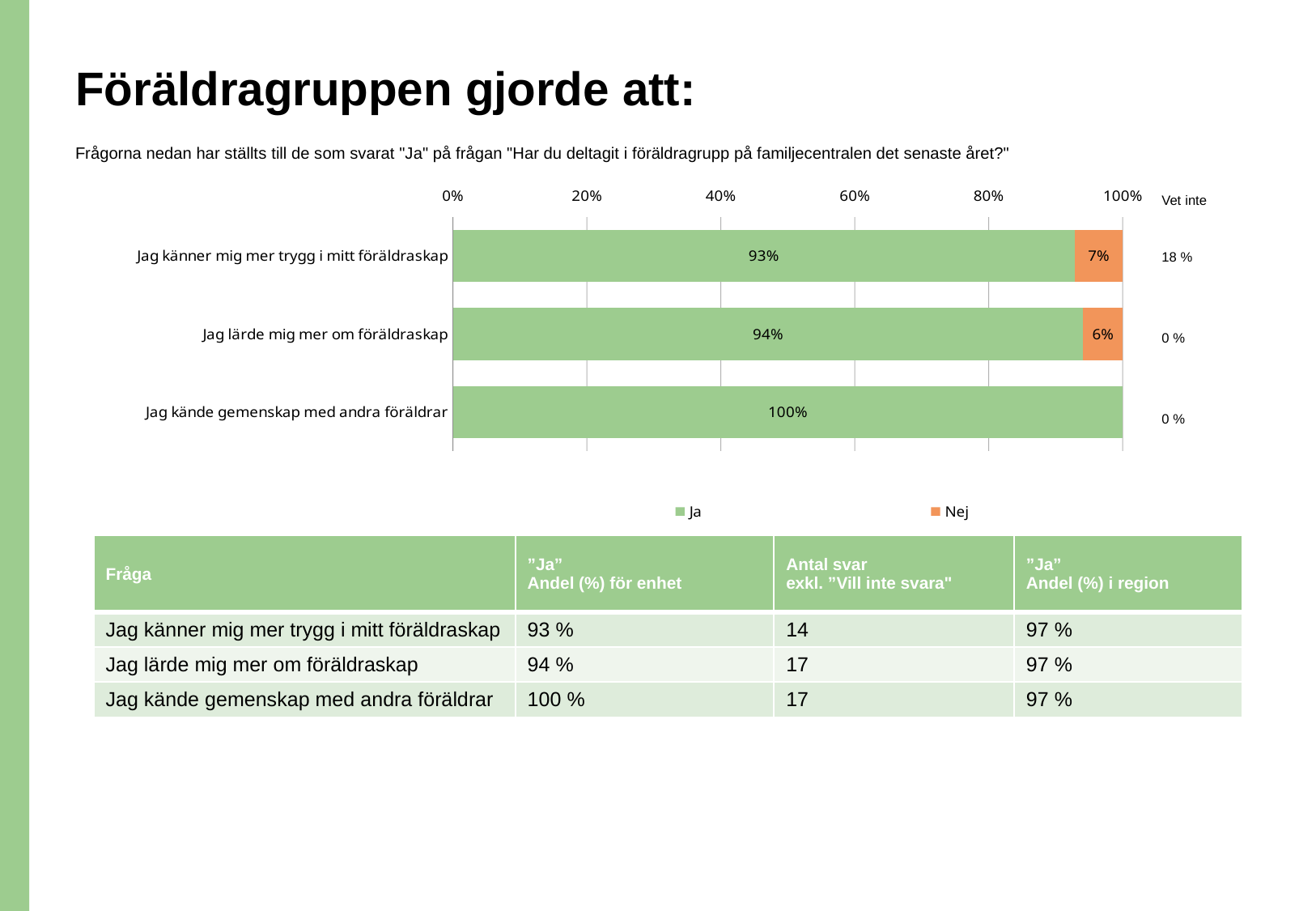
Which category has the lowest "Ja" value? Jag känner mig mer trygg i mitt föräldraskap What is the "Ja" value for "Jag kände gemenskap med andra föräldrar"? 100% Which category has the highest "Ja" value? Jag kände gemenskap med andra föräldrar What is the "Ja" value for "Jag känner mig mer trygg i mitt föräldraskap"? 93% How many series does the chart legend list? 2 What is the "Nej" value for "Jag känner mig mer trygg i mitt föräldraskap"? 7% What kind of chart is shown on the slide? Stacked bar chart What is the difference between the "Ja" values for "Jag kände gemenskap med andra föräldrar" and "Jag lärde mig mer om föräldraskap"? 6% Which is larger: the "Nej" value for "Jag känner mig mer trygg i mitt föräldraskap" or for "Jag lärde mig mer om föräldraskap"? Jag känner mig mer trygg i mitt föräldraskap What is the "Vet inte" value shown next to the bar for "Jag känner mig mer trygg i mitt föräldraskap"? 18 % How many categories are plotted in the chart? 3 What is the "Nej" value for "Jag lärde mig mer om föräldraskap"? 6%